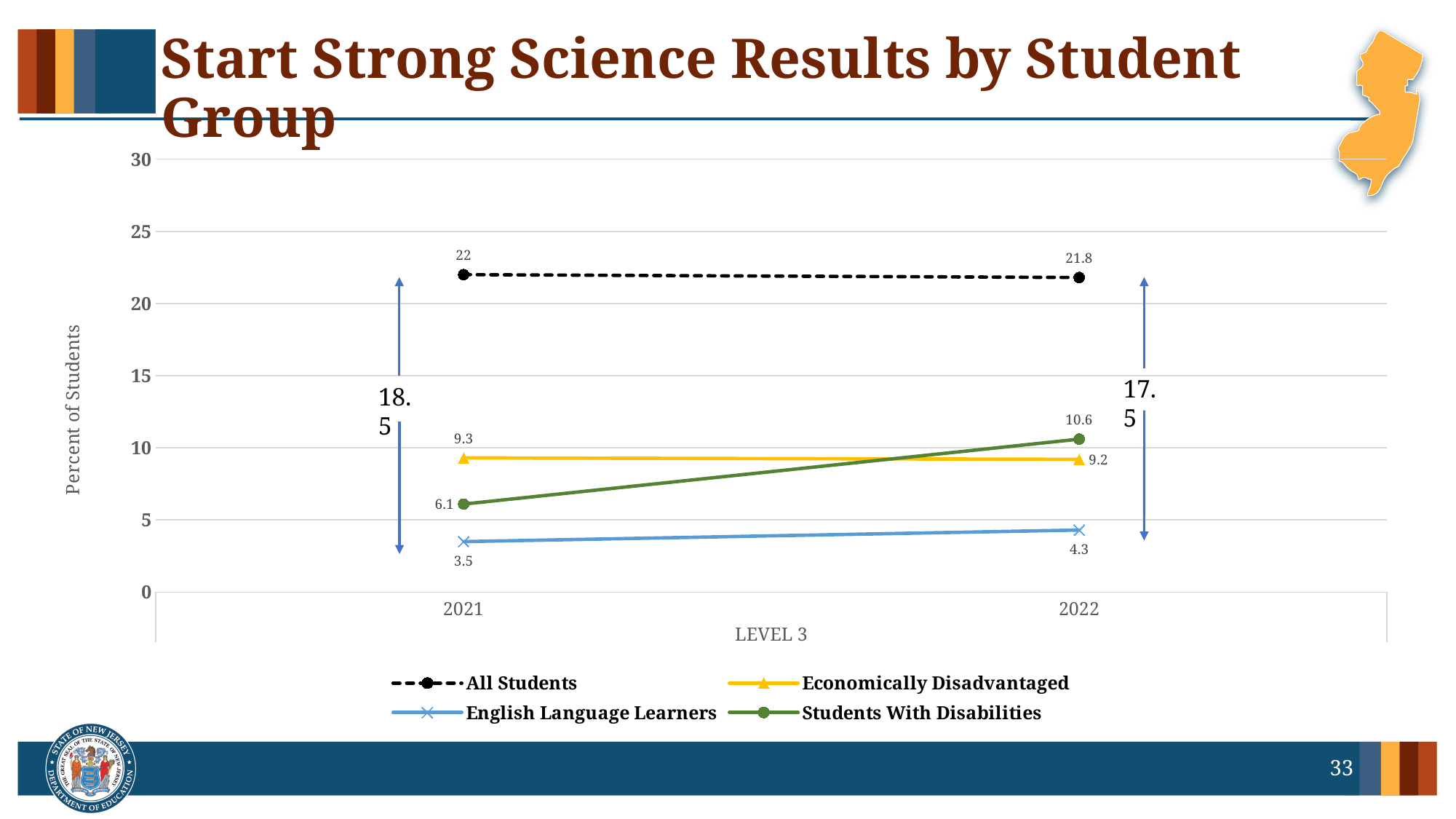
How many series does the legend list? 4 In 2022, which is larger: the value for Students With Disabilities or for Economically Disadvantaged? Students With Disabilities What percent of All Students reached Level 3 in 2021? 22 What is the difference between the All Students value and the English Language Learners value in 2021? 18.5 By how much did the Students With Disabilities value change from 2021 to 2022? 4.5 Does the All Students line rise or fall from 2021 to 2022? Fall What is the value for Economically Disadvantaged students in 2022? 9.2 What is the value for English Language Learners in 2021? 3.5 What kind of chart is shown on the slide? Line chart Which student group has the lowest value in 2021? English Language Learners What is the value for Students With Disabilities in 2022? 10.6 Which student group has the highest value in 2022? All Students